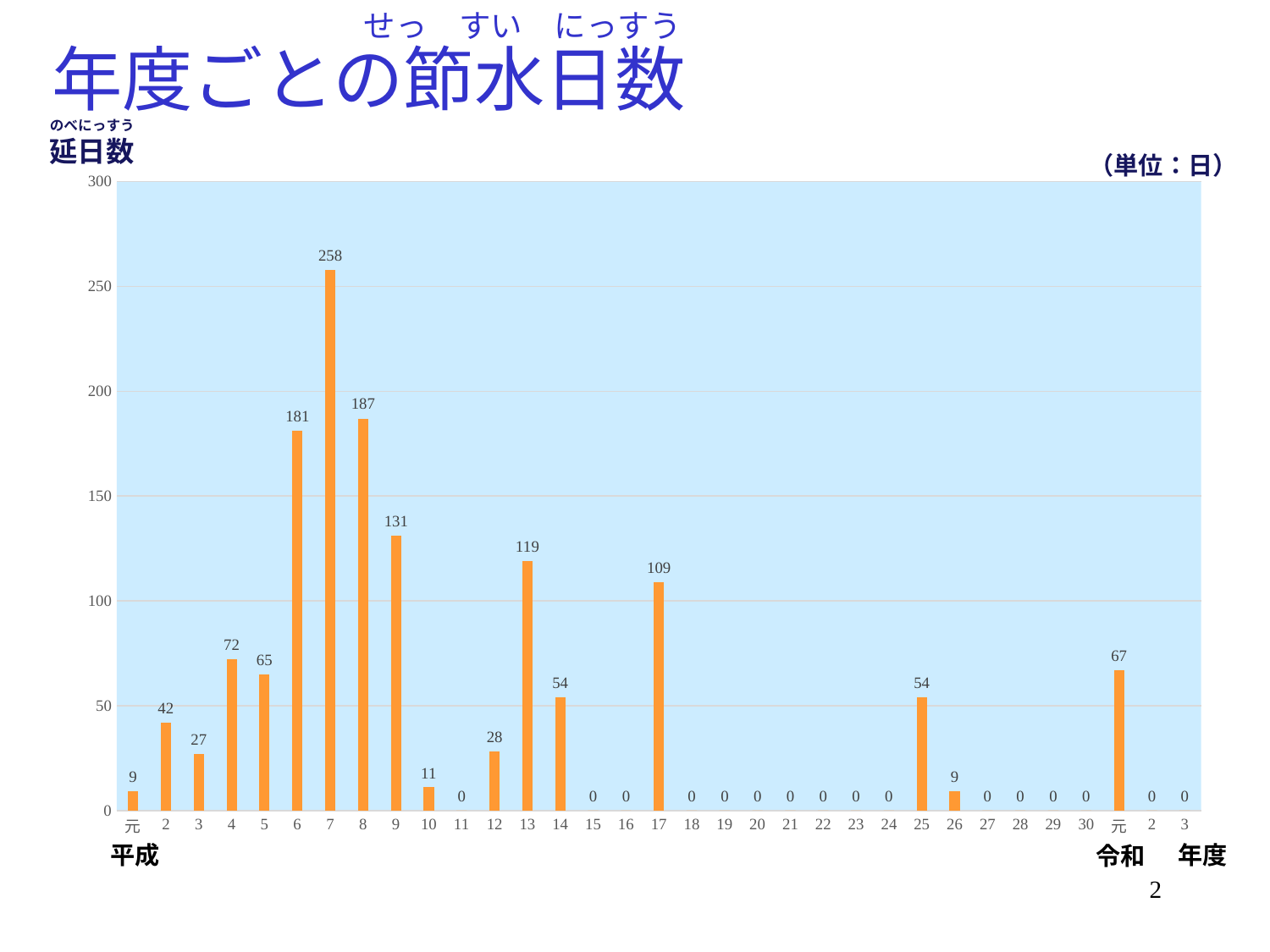
Is the value for 平成17年度 greater or less than 100? greater What is the value for 平成13年度? 119 What is the value for 令和元年度? 67 How many fiscal years are shown on the x axis? 33 What is the value for 平成7年度? 258 What is the difference between the values for 平成6年度 and 平成9年度? 50 Which fiscal year has the highest value? 平成7年度 What is the value for 平成25年度? 54 Which is larger, the value for 平成4年度 or the value for 平成5年度? 平成4年度 What unit is indicated for the values in the chart? 日 What kind of chart is shown on the slide? bar chart What is the difference between the values for 平成7年度 and 平成8年度? 71